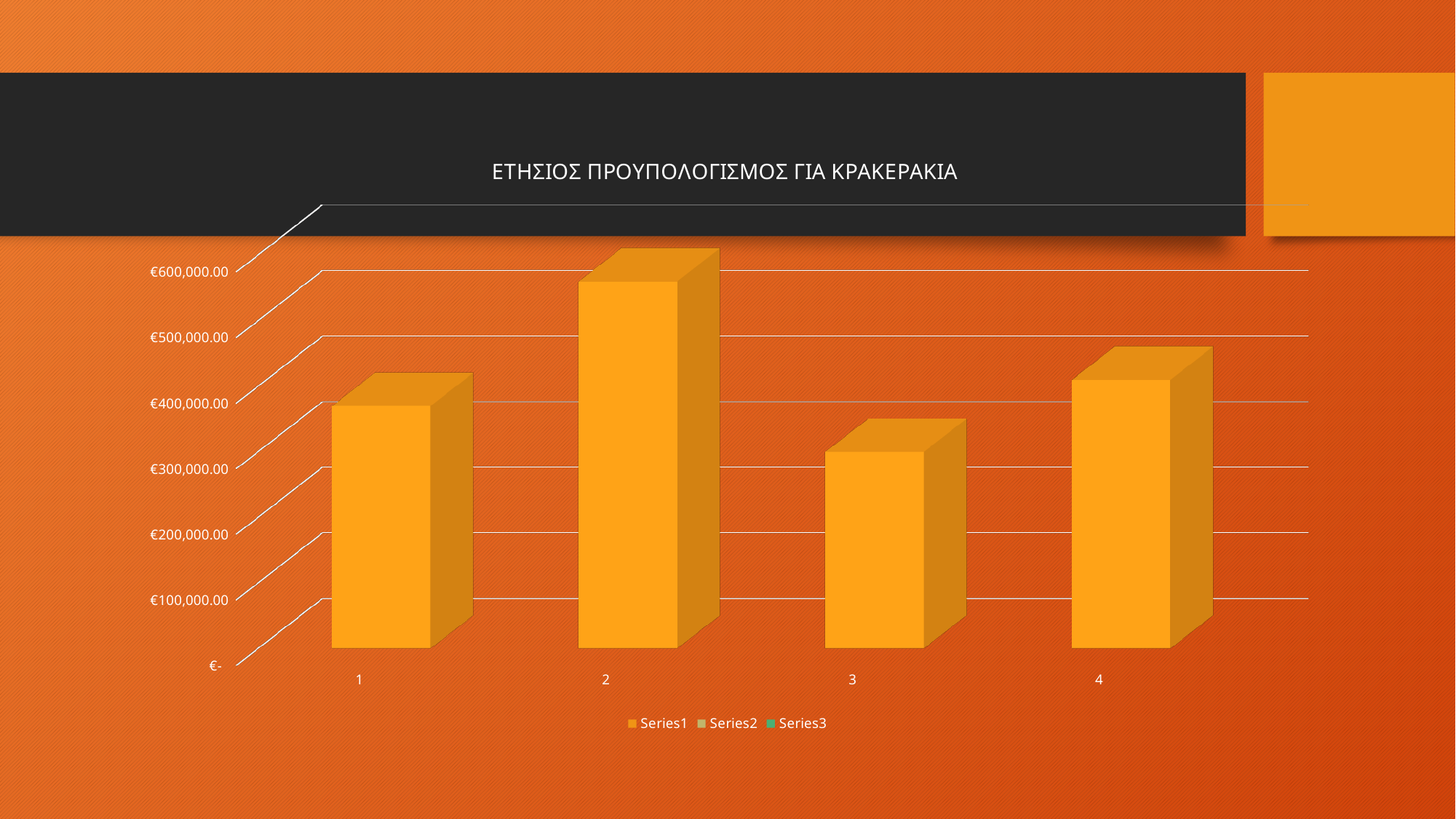
How many categories are shown on the x axis of the chart? 4 Is the value for category 1 greater or less than €300,000.00? greater Which category has the highest bar? 2 Is the value for category 4 greater or less than €500,000.00? less What is the title of the chart? ΕΤΗΣΙΟΣ ΠΡΟΥΠΟΛΟΓΙΣΜΟΣ ΓΙΑ ΚΡΑΚΕΡΑΚΙΑ What kind of chart is shown on the slide? Bar chart Which category has the lowest bar? 3 Is the value for category 2 greater or less than €500,000.00? greater Which is larger, the value for category 1 or the value for category 3? Category 1 Which is larger, the value for category 2 or the value for category 4? Category 2 How many series does the chart legend list? 3